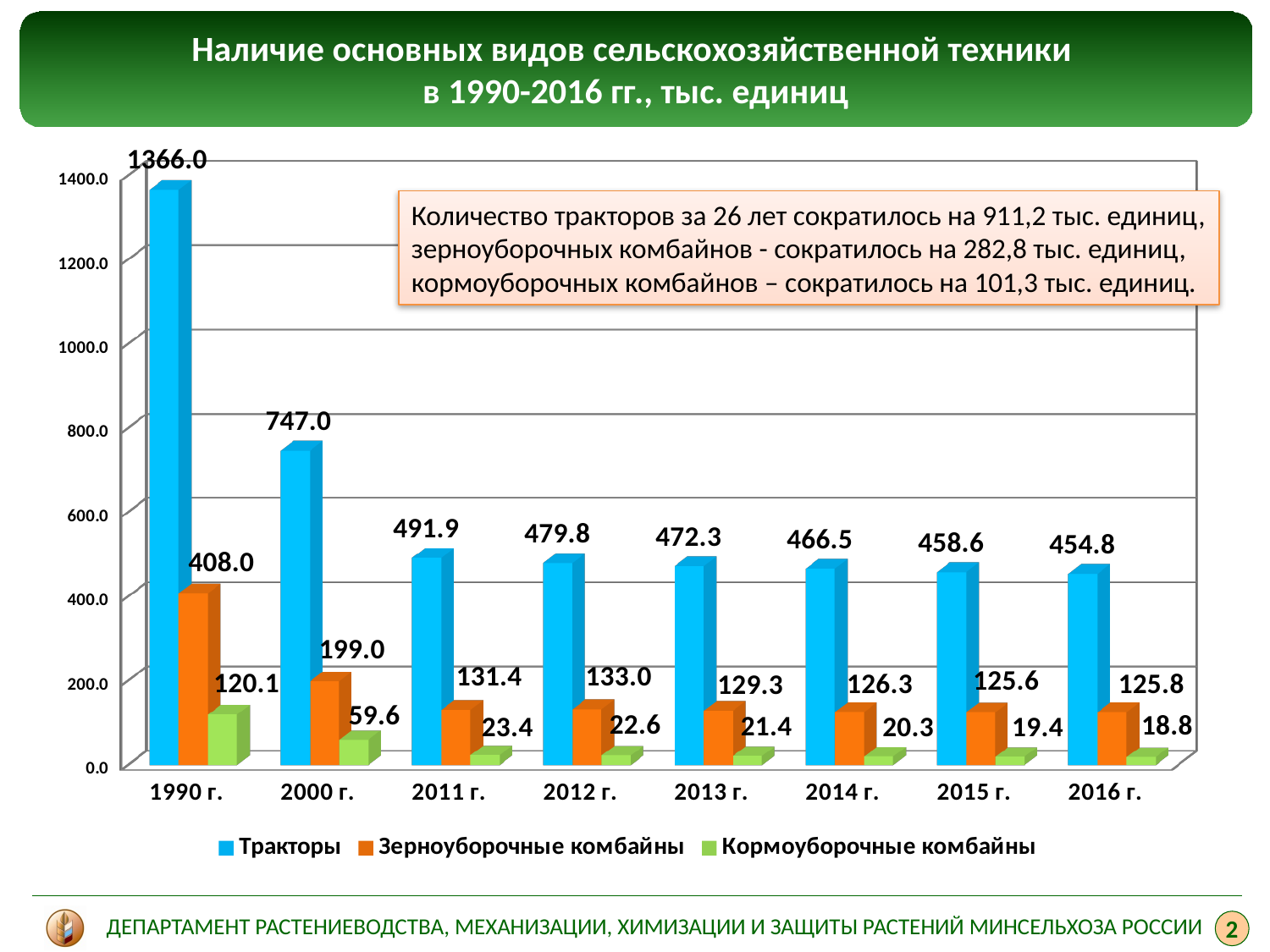
In which year is the value for Кормоуборочные комбайны the highest? 1990 г. What is the difference between the Тракторы values in 1990 г. and 2016 г.? 911.2 How many years are shown on the x axis? 8 What kind of chart is shown on the slide? bar chart What is the value for Кормоуборочные комбайны in 2016 г.? 18.8 How many series does the legend list? 3 What is the value for Тракторы in 1990 г.? 1366.0 Which is larger: Зерноуборочные комбайны in 2011 г. or in 2012 г.? 2012 г. Do the values for Тракторы rise or fall from 1990 г. to 2016 г.? fall What is the value for Зерноуборочные комбайны in 2000 г.? 199.0 Is the value for Тракторы in 2000 г. greater or less than 600.0? greater In which year is the value for Тракторы the lowest? 2016 г.